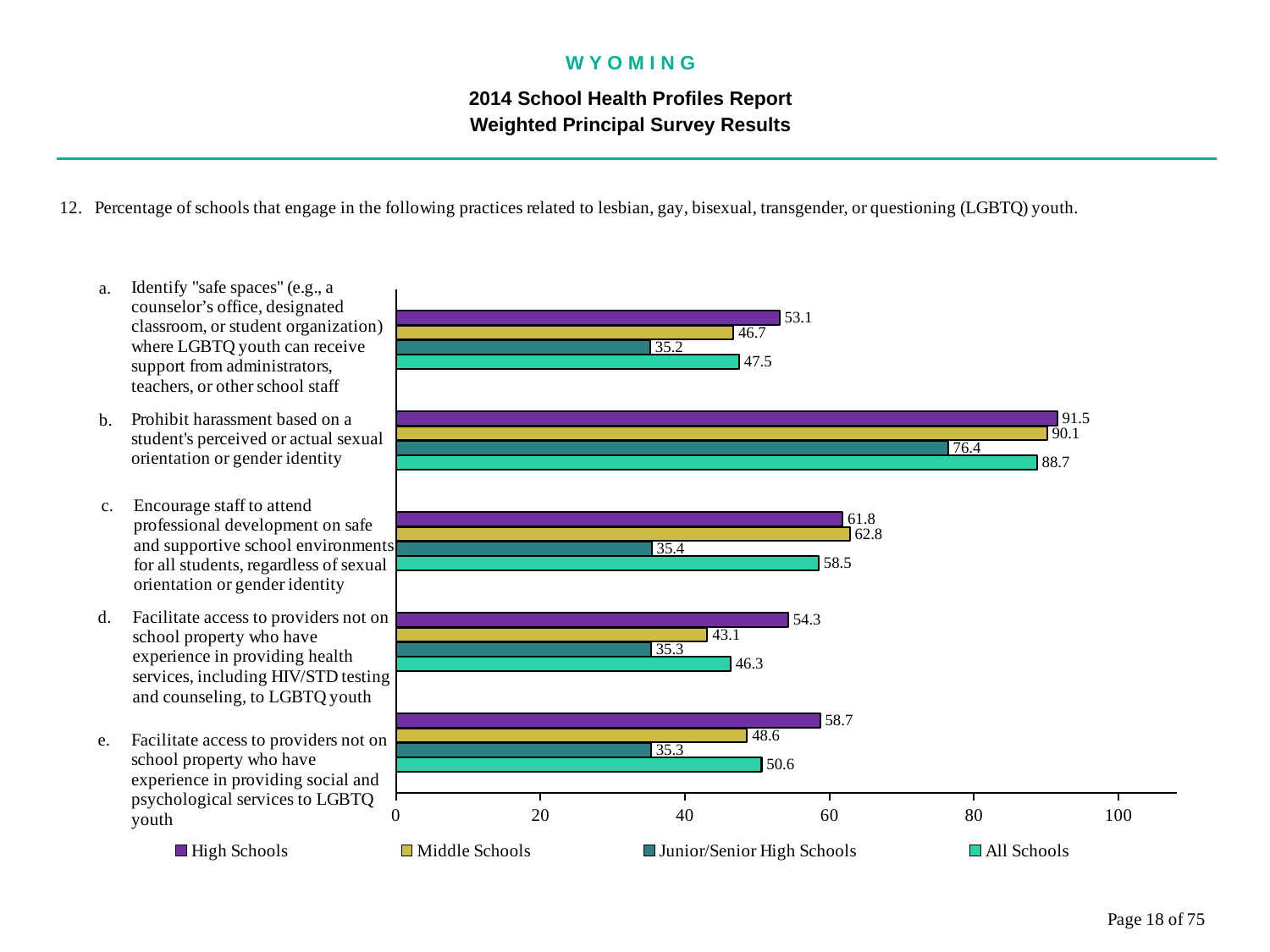
Which practice has the highest All Schools value? b. Prohibit harassment based on a student's perceived or actual sexual orientation or gender identity How many series does the legend list? 4 Which series is shown in the legend with the purple colour? High Schools What is the Junior/Senior High Schools value for practice a, identifying "safe spaces" where LGBTQ youth can receive support? 35.2 Is the Junior/Senior High Schools value for practice b, prohibiting harassment, greater or less than 60? greater How many practices (categories) are shown on the chart? 5 What is the All Schools value for practice e, facilitating access to providers not on school property who provide social and psychological services to LGBTQ youth? 50.6 For practice c, encouraging staff to attend professional development on safe and supportive school environments, which is larger: the High Schools value or the Middle Schools value? Middle Schools What is the difference between the High Schools and Middle Schools values for practice d, facilitating access to health service providers for LGBTQ youth? 11.2 Which practice has the lowest Middle Schools value? d. Facilitate access to providers not on school property who have experience in providing health services, including HIV/STD testing and counseling, to LGBTQ youth What is the High Schools value for practice b, prohibiting harassment based on a student's perceived or actual sexual orientation or gender identity? 91.5 What kind of chart is shown on the slide? Bar chart